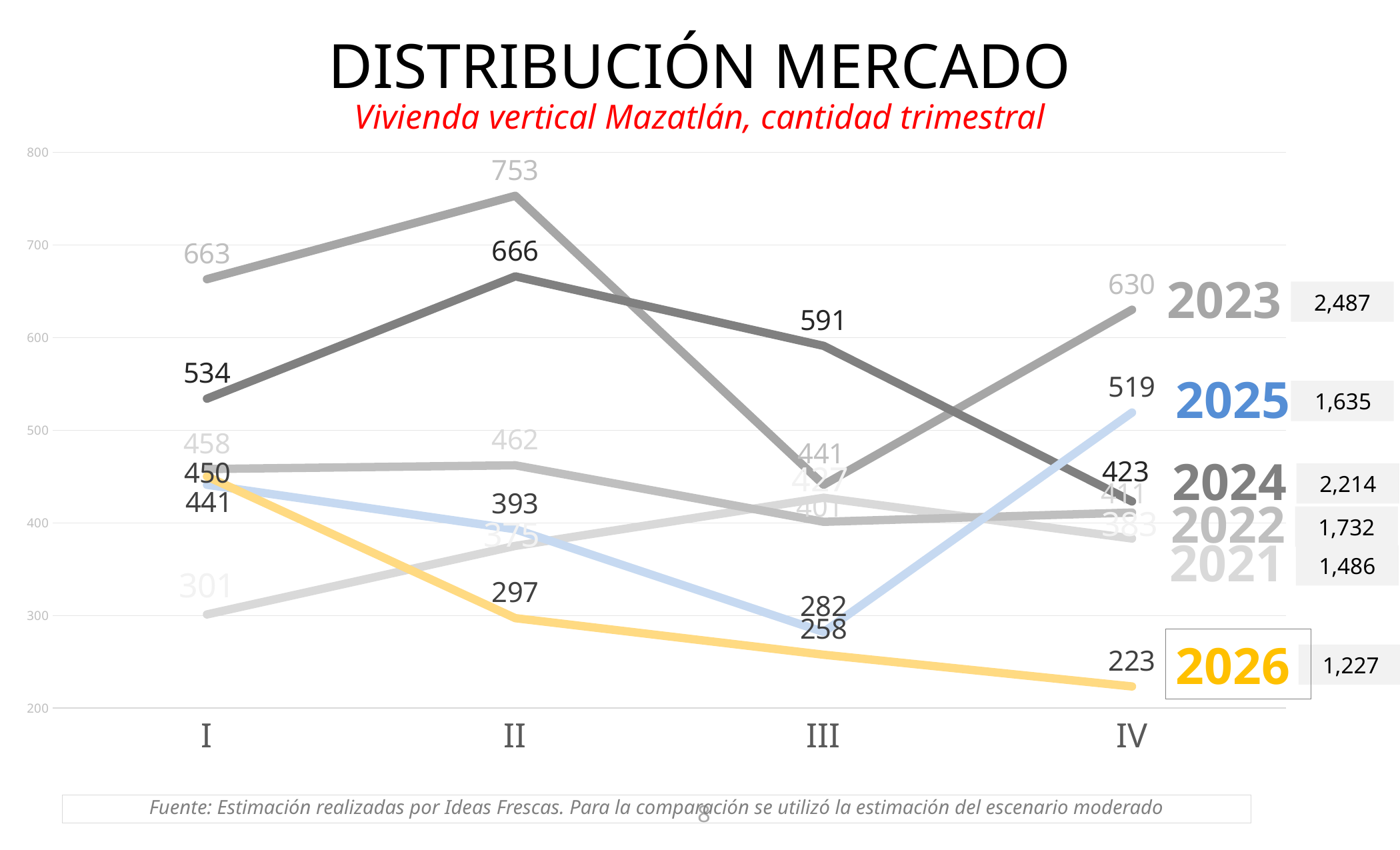
How many year series are plotted on the chart? 6 What is the value for 2025 in quarter IV? 519 What is the difference between the 2024 values in quarter II and quarter I? 132 In which quarter does the 2023 series reach its highest value? II Which year has the lowest value in quarter IV? 2026 How many quarters are shown along the x axis? 4 In quarter I, which is larger: the value for 2023 or the value for 2024? 2023 Does the 2026 series rise or fall from quarter I to quarter IV? fall What is the value for 2023 in quarter II? 753 What is the value for 2026 in quarter IV? 223 What is the value for 2024 in quarter III? 591 What kind of chart is shown on the slide? line chart